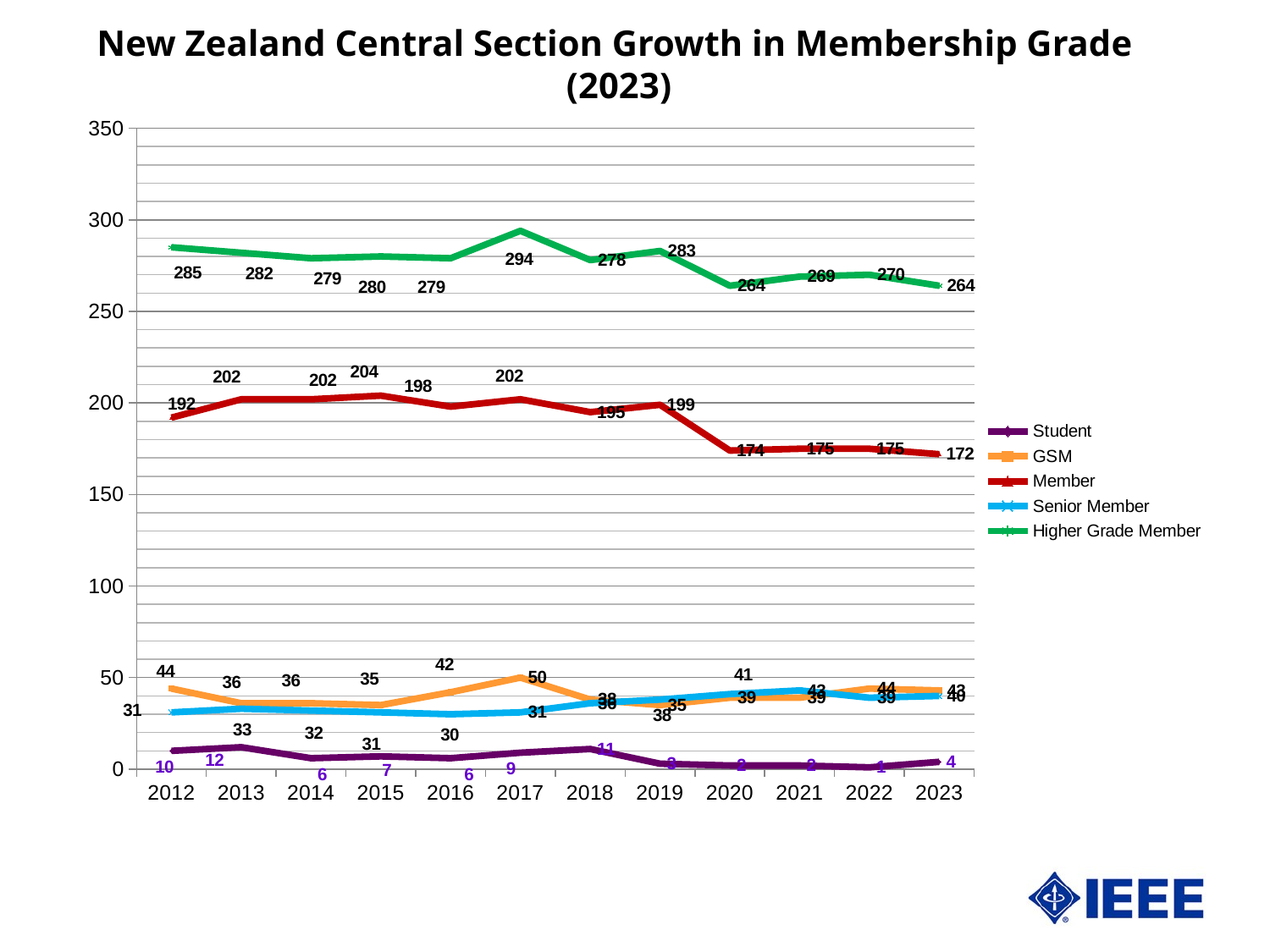
In which year is the Member value lowest? 2023 What is the value for GSM in 2017? 50 In which year is the Higher Grade Member value highest? 2017 What is the difference between the Higher Grade Member values in 2012 and 2023? 21 What is the value for Higher Grade Member in 2017? 294 How many series does the legend list? 5 Is the value for Member in 2020 greater or less than 200? less What is the value for Student in 2013? 12 What kind of chart is shown on the slide? line chart How many years are shown on the x axis? 12 Which is larger, the Member value in 2015 or in 2016? 2015 What is the value for Member in 2023? 172